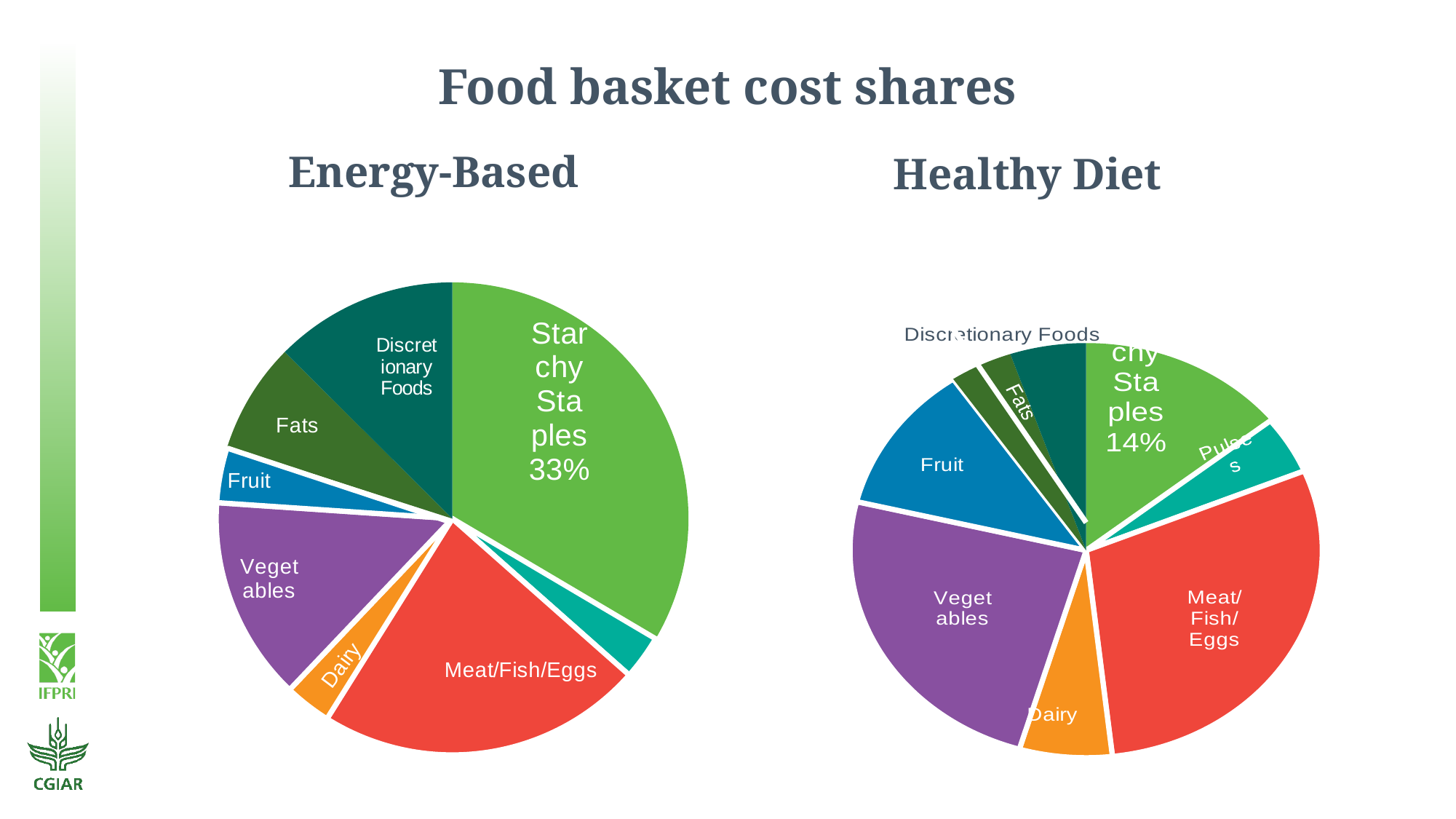
In the Energy-Based chart, what share of the food basket cost is Starchy Staples? 33% By how many percentage points does the Starchy Staples share in the Energy-Based chart exceed that in the Healthy Diet chart? 19 percentage points In the Energy-Based chart, which category has the largest share? Starchy Staples In the Healthy Diet chart, which is larger: Meat/Fish/Eggs or Fats? Meat/Fish/Eggs How many slices does the Energy-Based pie chart have? 8 In the Healthy Diet chart, which is larger: Fruit or Dairy? Fruit In the Healthy Diet chart, what share of the food basket cost is Starchy Staples? 14% In the Energy-Based chart, which is larger: Vegetables or Dairy? Vegetables What is the title of the slide containing the two pie charts? Food basket cost shares What kind of chart is used for the Energy-Based food basket? Pie chart